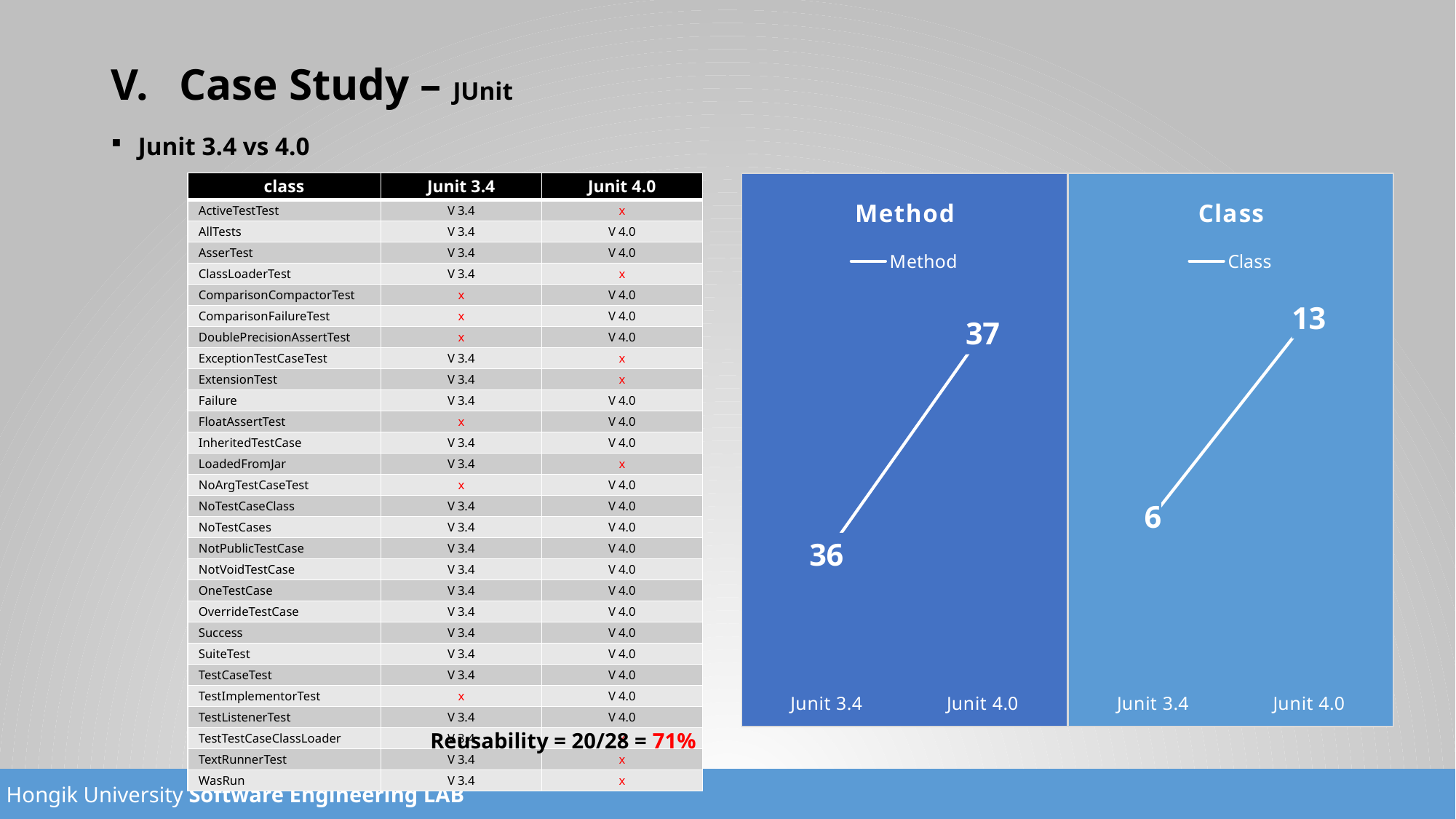
In the Method chart, what is the difference between the Junit 4.0 and Junit 3.4 values? 1 What kind of chart is the Class chart? line chart How many categories are shown on the x axis of the Class chart? 2 How many series does the legend of the Method chart list? 1 In the Class chart, which category has the higher value, Junit 3.4 or Junit 4.0? Junit 4.0 In the Method chart, which category has the lowest value? Junit 3.4 In the Class chart, what is the value for Junit 3.4? 6 In the Method chart, what is the value for Junit 3.4? 36 In the Method chart, what is the value for Junit 4.0? 37 In the Method chart, do the values rise or fall from Junit 3.4 to Junit 4.0? rise In the Class chart, what is the value for Junit 4.0? 13 In the Class chart, what is the difference between the Junit 4.0 and Junit 3.4 values? 7